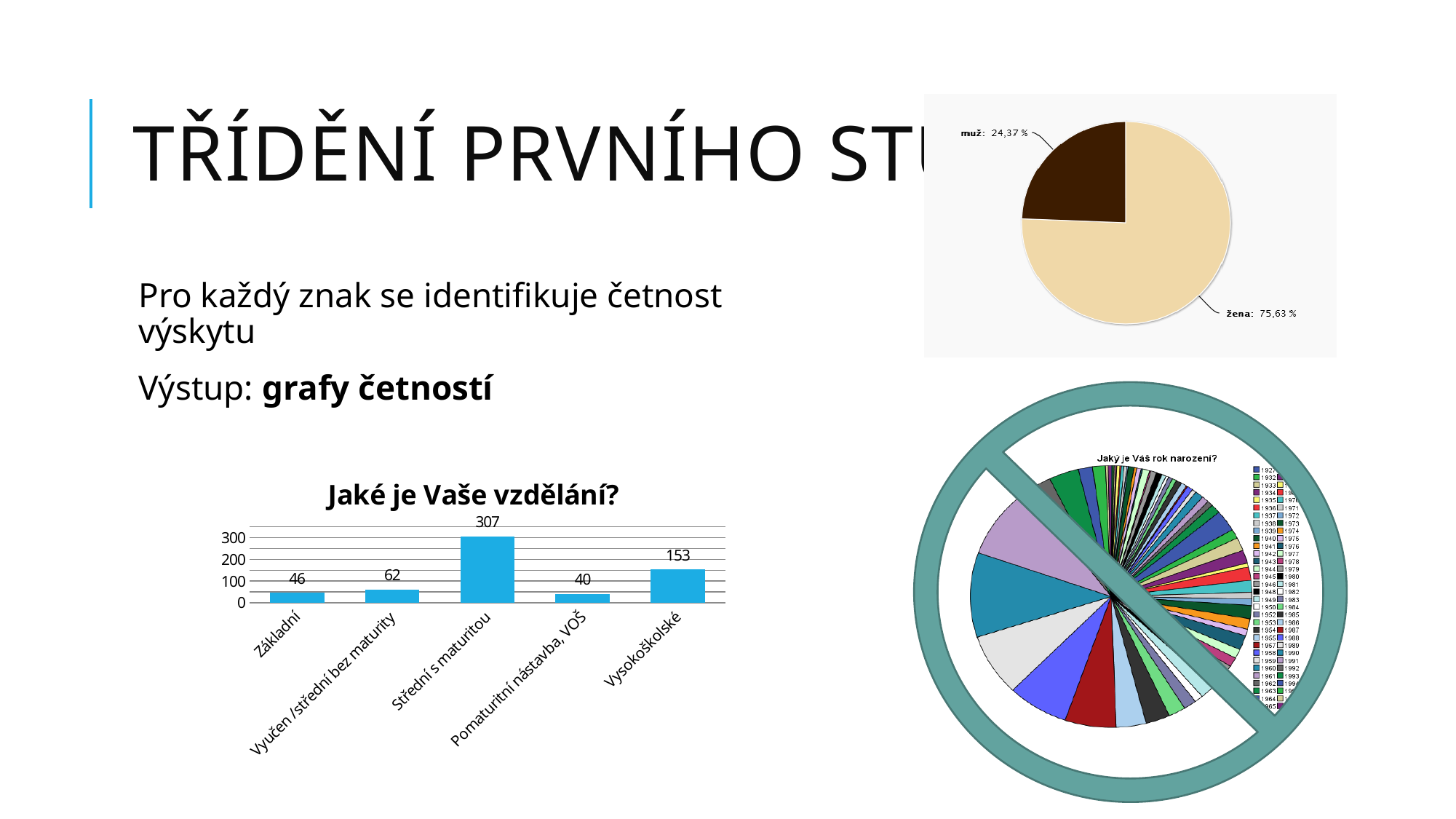
In the bar chart 'Jaké je Vaše vzdělání?', what is the value for 'Základní'? 46 In the bar chart 'Jaké je Vaše vzdělání?', which category has the highest value? Střední s maturitou In the bar chart 'Jaké je Vaše vzdělání?', what is the value for 'Vysokoškolské'? 153 In the bar chart 'Jaké je Vaše vzdělání?', which category has the lowest value? Pomaturitní nástavba, VOŠ What is the title of the crossed-out pie chart at the bottom right of the slide? Jaký je Váš rok narození? What kind of chart is 'Jaké je Vaše vzdělání?'? bar chart How many categories does the bar chart 'Jaké je Vaše vzdělání?' show? 5 In the bar chart 'Jaké je Vaše vzdělání?', what is the value for 'Střední s maturitou'? 307 In the bar chart 'Jaké je Vaše vzdělání?', which is larger: 'Základní' or 'Vyučen /střední bez maturity'? Vyučen /střední bez maturity In the pie chart at the top right of the slide, what share is labelled for 'žena'? 75,63 % In the pie chart at the top right of the slide, what share is labelled for 'muž'? 24,37 % In the bar chart 'Jaké je Vaše vzdělání?', what is the difference between the values for 'Střední s maturitou' and 'Vysokoškolské'? 154